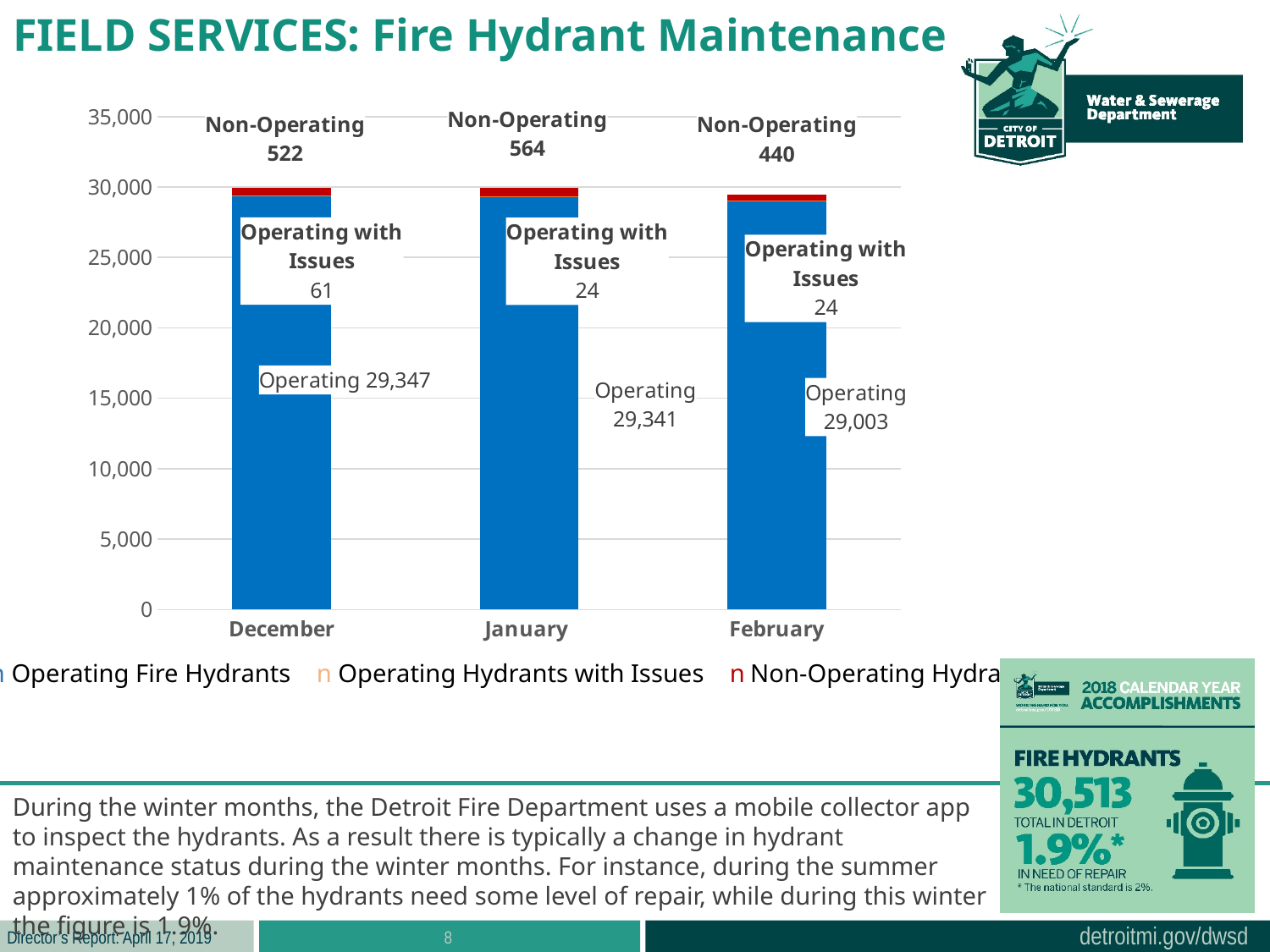
What kind of chart is shown on the slide? Stacked bar chart Does the Operating value rise or fall from December to February? Fall What is the number of Operating fire hydrants in December? 29,347 What is the total of the stacked bar for December? 29,930 Which is larger, the Operating with Issues value for December or for January? December How many months are shown on the x axis? 3 How many series does the legend list? 3 Which month has the highest Non-Operating value? January How many Operating with Issues hydrants are shown for February? 24 What is the Non-Operating value for January? 564 What is the difference between the Non-Operating values for January and February? 124 Which month has the lowest Operating value? February